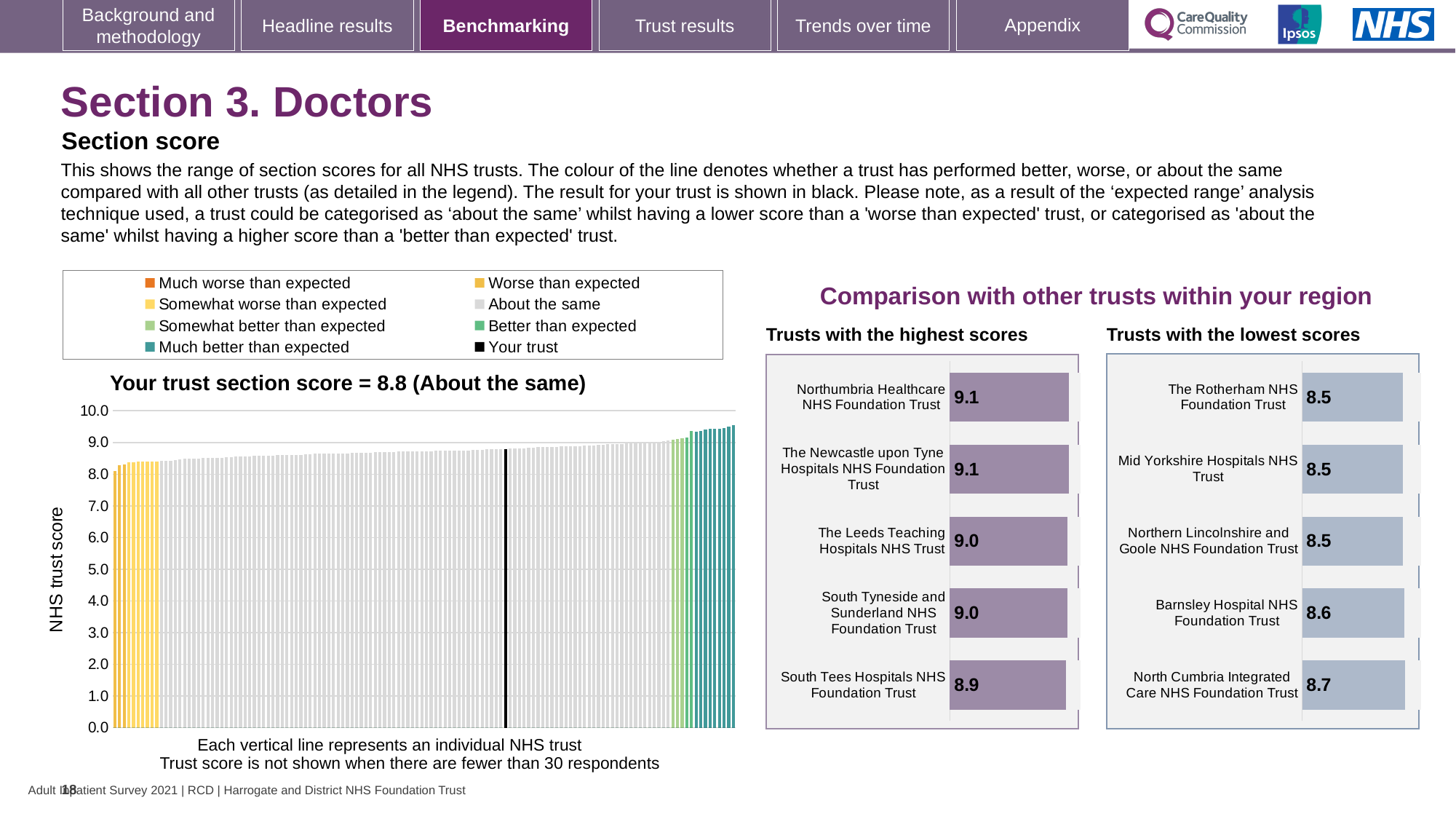
In the 'Trusts with the highest scores' chart, which trust has the lowest score? South Tees Hospitals NHS Foundation Trust In the main chart on the left, what is the section score for your trust? 8.8 In the 'Trusts with the highest scores' chart, what is the score for The Leeds Teaching Hospitals NHS Trust? 9.0 What type of chart is the 'Trusts with the highest scores' chart? bar chart In the 'Trusts with the highest scores' chart, what is the score for South Tees Hospitals NHS Foundation Trust? 8.9 In the main chart on the left, are the values of the lowest-scoring trusts greater or less than 7.0? greater In the 'Trusts with the lowest scores' chart, which has the larger score: The Rotherham NHS Foundation Trust or North Cumbria Integrated Care NHS Foundation Trust? North Cumbria Integrated Care NHS Foundation Trust In the 'Trusts with the lowest scores' chart, what is the score for Barnsley Hospital NHS Foundation Trust? 8.6 In the 'Trusts with the highest scores' chart, what is the difference between the scores of Northumbria Healthcare NHS Foundation Trust and South Tees Hospitals NHS Foundation Trust? 0.2 In the 'Trusts with the lowest scores' chart, which trust has the highest score? North Cumbria Integrated Care NHS Foundation Trust How many entries does the legend of the main chart on the left list? 8 How many trusts are shown in the 'Trusts with the lowest scores' chart? 5